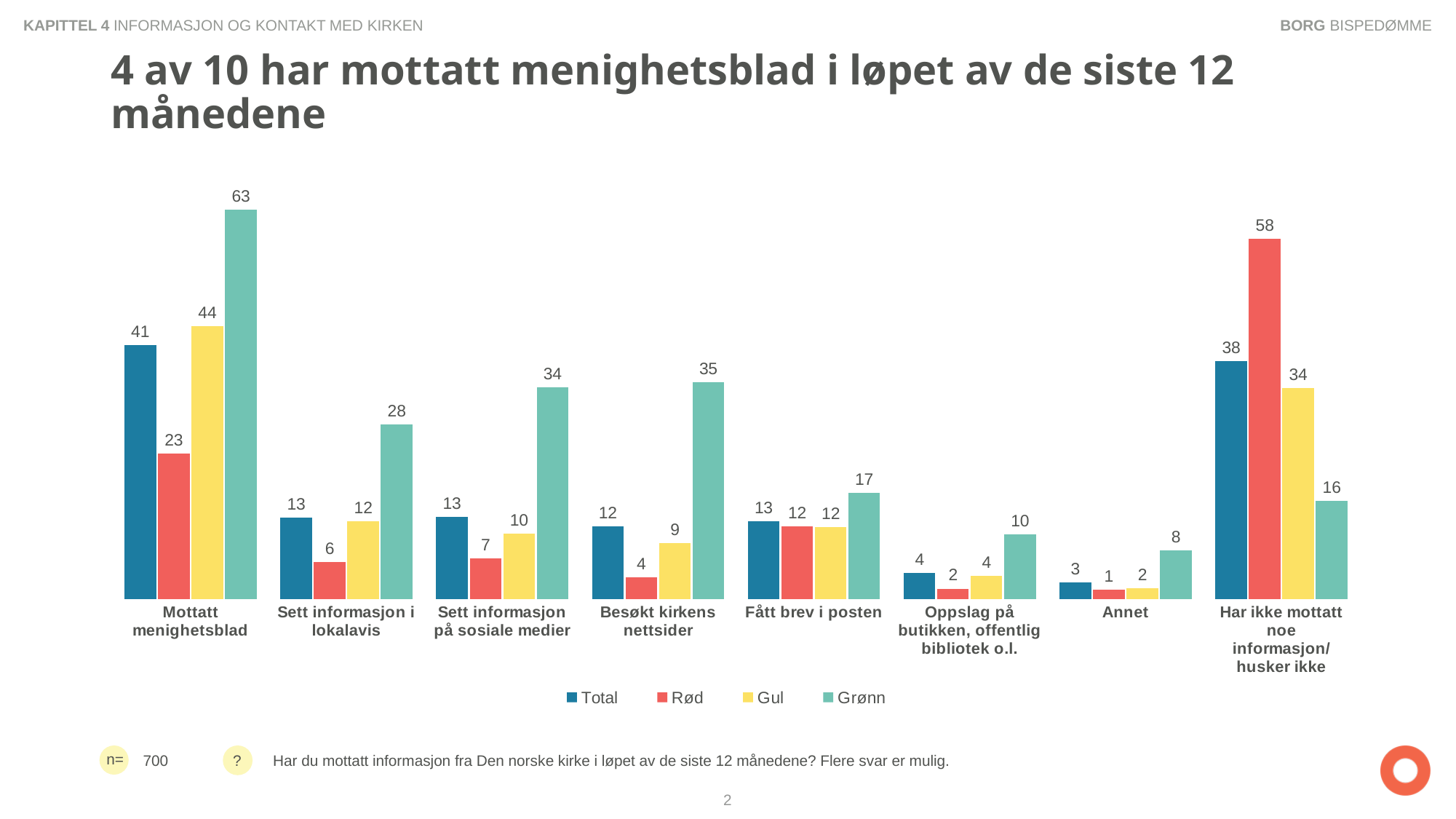
Which category has the highest Grønn value? Mottatt menighetsblad What kind of chart is shown on the slide? Bar chart What is the Rød value for "Har ikke mottatt noe informasjon/ husker ikke"? 58 What is the Gul value for "Fått brev i posten"? 12 Which is larger for "Sett informasjon i lokalavis": the Gul value or the Grønn value? Grønn Which series is shown in red in the legend? Rød How many categories are shown on the x axis? 8 What is the Total value for "Mottatt menighetsblad"? 41 Which category has the lowest Total value? Annet How many series does the legend list? 4 What is the Grønn value for "Besøkt kirkens nettsider"? 35 What is the difference between the Grønn and Rød values for "Mottatt menighetsblad"? 40